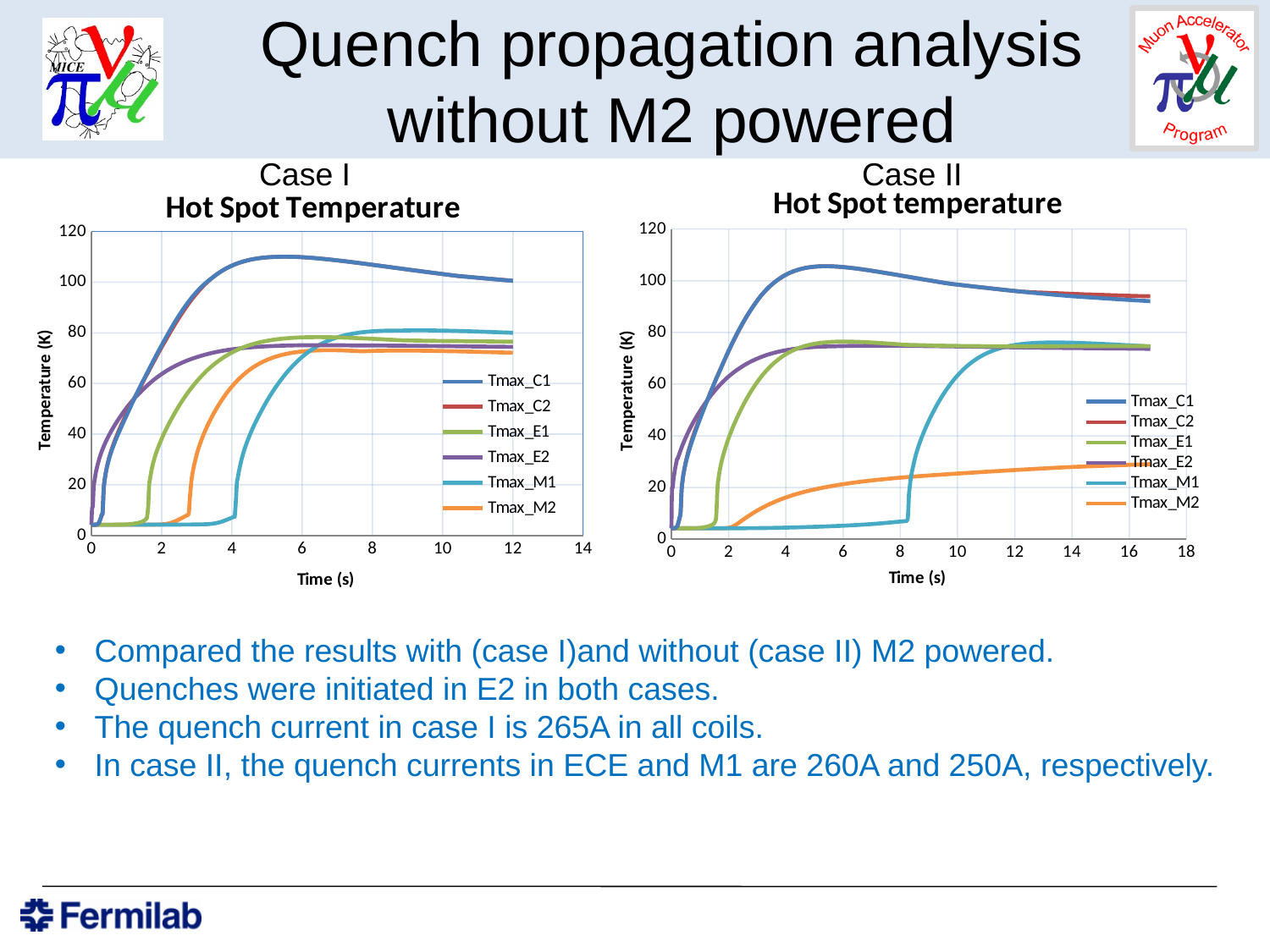
How many series does the legend of the Case II chart list? 6 In the Case I chart, at 12 s, which is higher: Tmax_C1 or Tmax_M2? Tmax_C1 What type of chart is the Case I Hot Spot Temperature chart? line chart What is the y-axis label of the Case I chart? Temperature (K) In the Case II chart, does Tmax_M2 rise or fall as time increases from 2 s to 16 s? rise What is the x-axis label of the Case II chart? Time (s) In the Case I chart, is the peak value of Tmax_C1 greater or less than 100? greater In the Case II chart, is the peak value of Tmax_E2 greater or less than 100? less In the Case II chart, is the final value of Tmax_M2 (at about 16 s) greater or less than 40? less In the Case II chart, at 16 s, which is higher: Tmax_M2 or Tmax_E1? Tmax_E1 How many series does the legend of the Case I chart list? 6